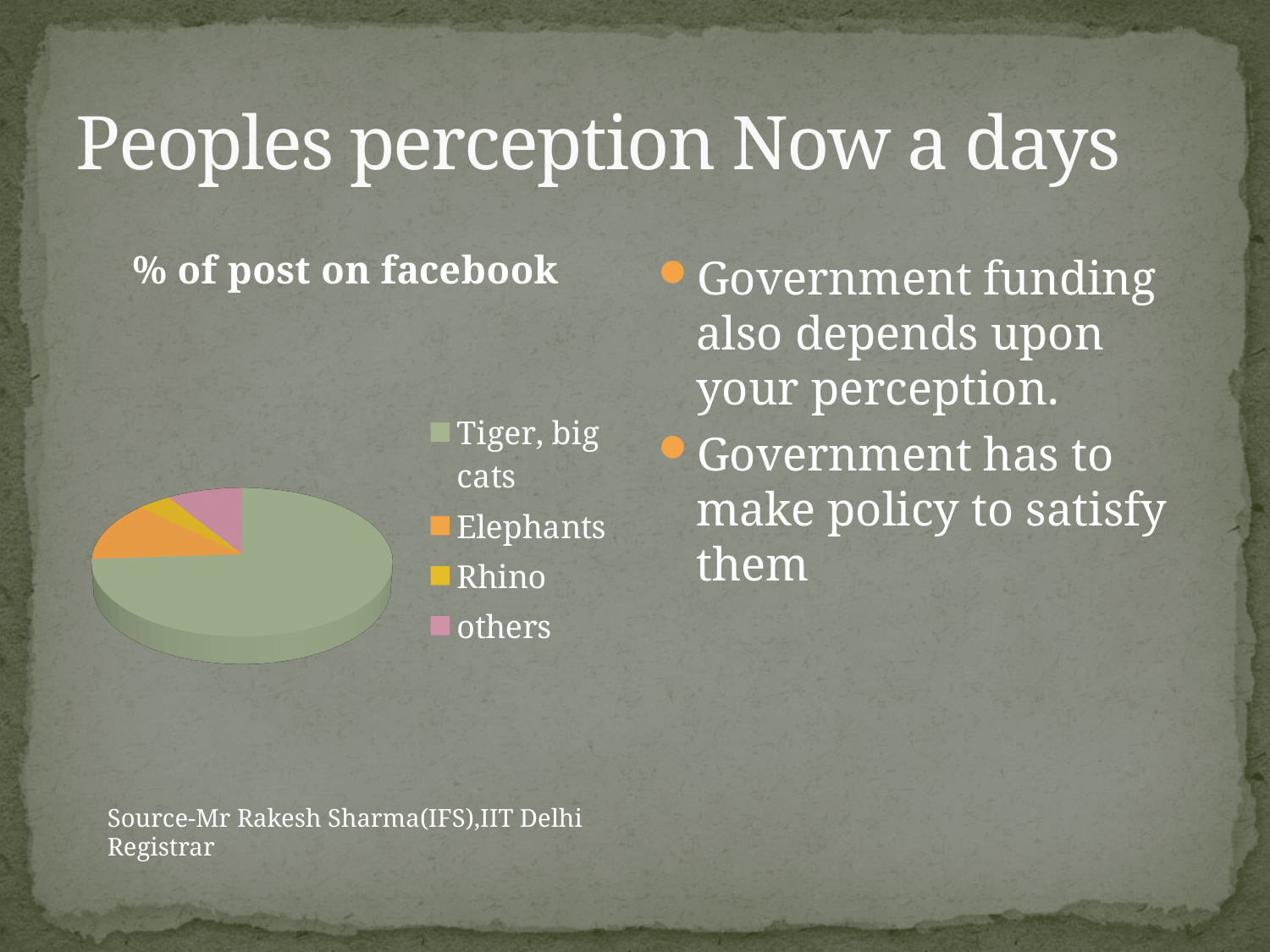
Which category has the largest slice of the pie? Tiger, big cats What kind of chart is shown on the slide? pie chart Which slice is larger, Tiger, big cats or others? Tiger, big cats Does the Tiger, big cats slice make up more or less than half of the pie? more How many categories does the pie chart show? 4 Which slice is larger, Tiger, big cats or Elephants? Tiger, big cats Which category has the smallest slice of the pie? Rhino Which category is shown in yellow in the legend? Rhino What is the title of the chart? % of post on facebook Which slice is larger, Elephants or Rhino? Elephants